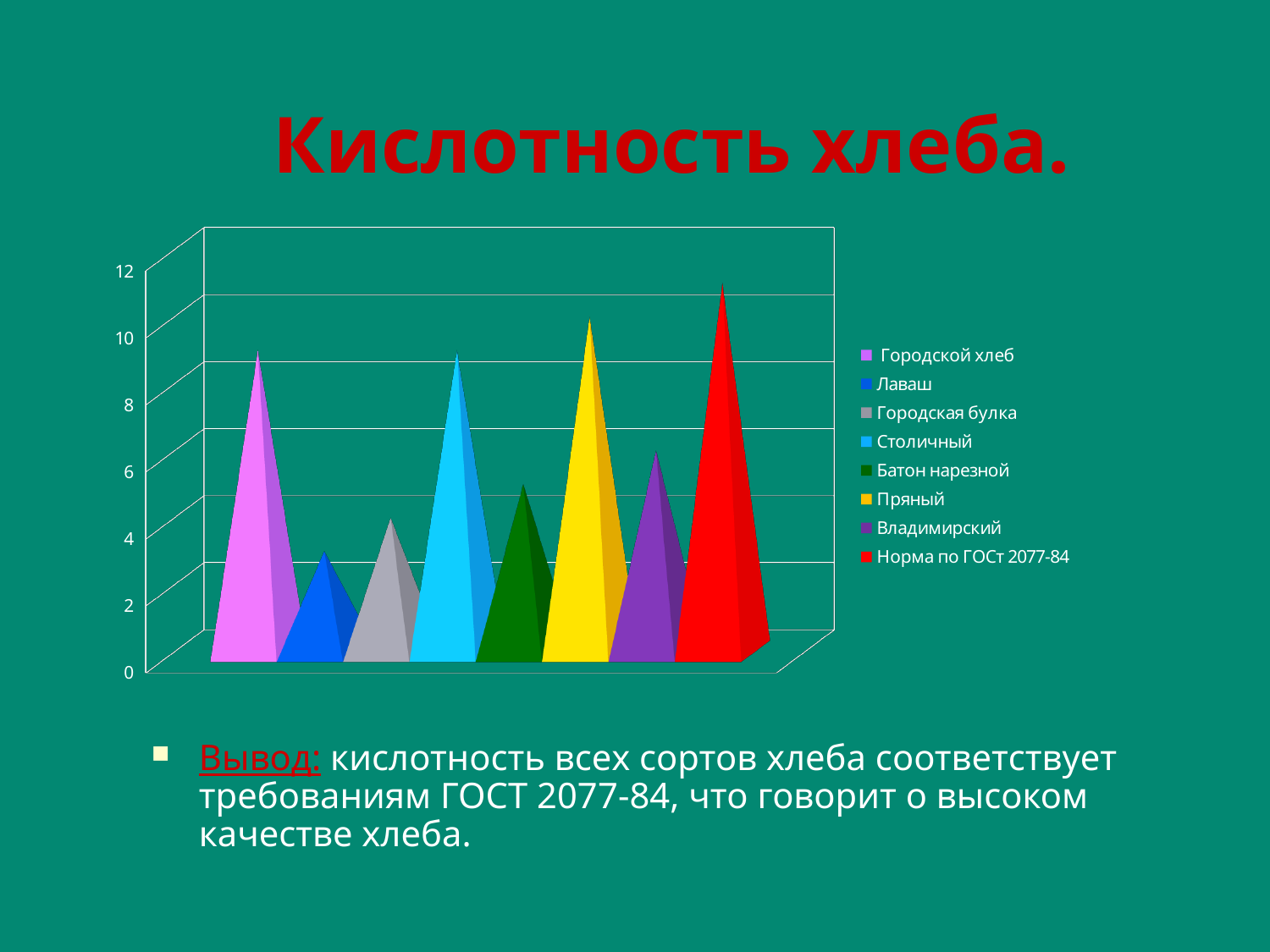
Is the value for Пряный greater or less than 8? greater Which is larger, the value for Пряный or the value for Батон нарезной? Пряный What is the title of the chart? Кислотность хлеба. Is the value for Батон нарезной greater or less than 6? less What kind of chart is shown on the slide? bar chart Which series has the highest value in the chart? Норма по ГОСт 2077-84 Which series has the lowest value in the chart? Лаваш Which is larger, the value for Столичный or the value for Городская булка? Столичный What colour represents Норма по ГОСт 2077-84 in the chart? red How many series does the chart legend list? 8 Is the value for Норма по ГОСт 2077-84 greater or less than 8? greater